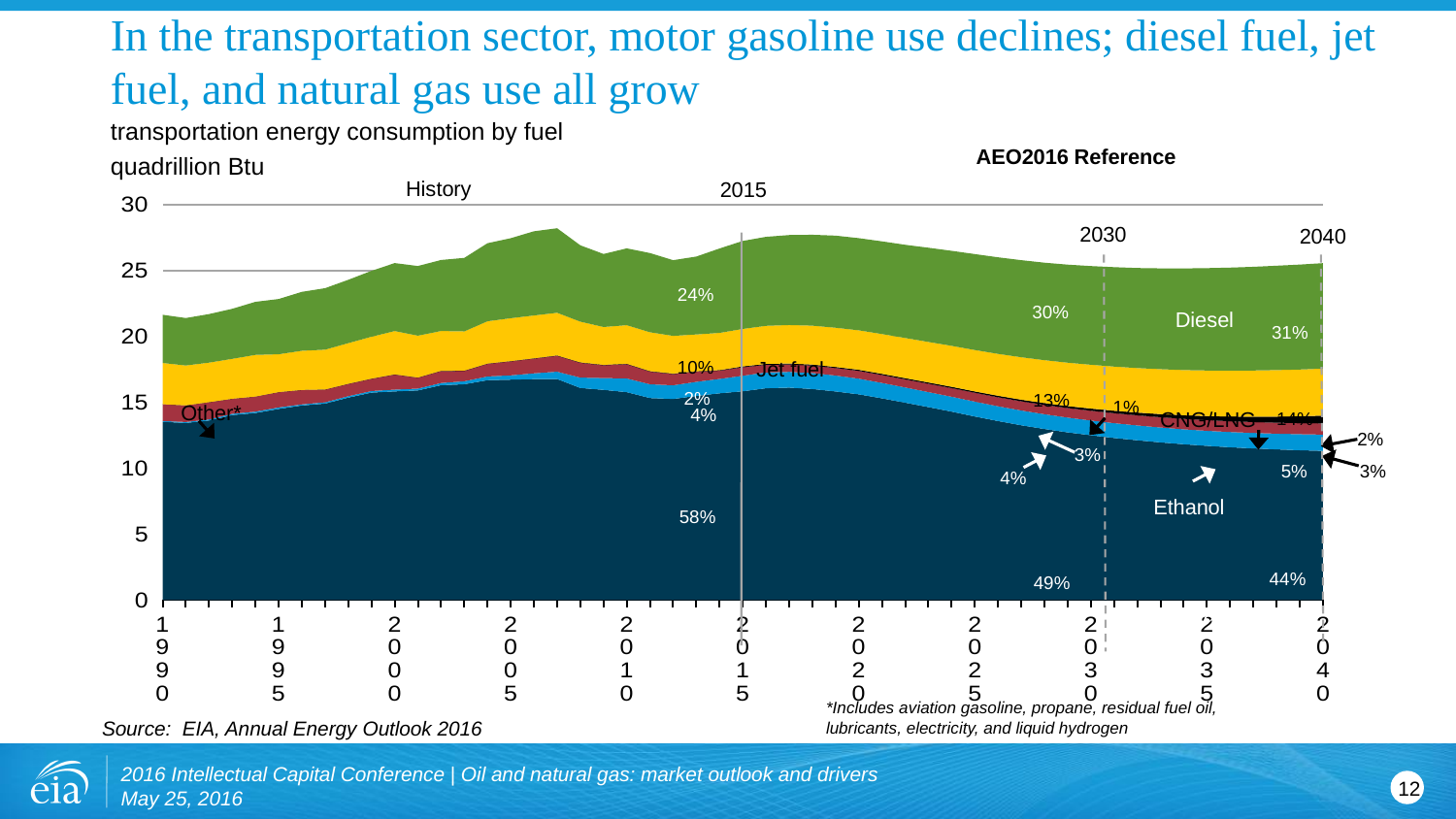
What share does Ethanol account for in 2040? 5% What share does Diesel account for in 2040? 31% In 2030, which has the larger share, Diesel or Jet fuel? Diesel By how many percentage points does the Diesel share change between 2015 and 2040? 7 percentage points What kind of chart is shown on the slide? stacked area chart What share does CNG/LNG account for in 2030? 1% What share does Jet fuel account for in 2030? 13% What share does the bottom (largest) band account for in 2015? 58% Does the share of the bottom (largest) band rise or fall from 2015 to 2040? fall What share of transportation energy consumption does Diesel account for in 2015? 24% What unit is used on the y axis of the chart? quadrillion Btu Is total transportation energy consumption in 1990 greater or less than 25 quadrillion Btu? less